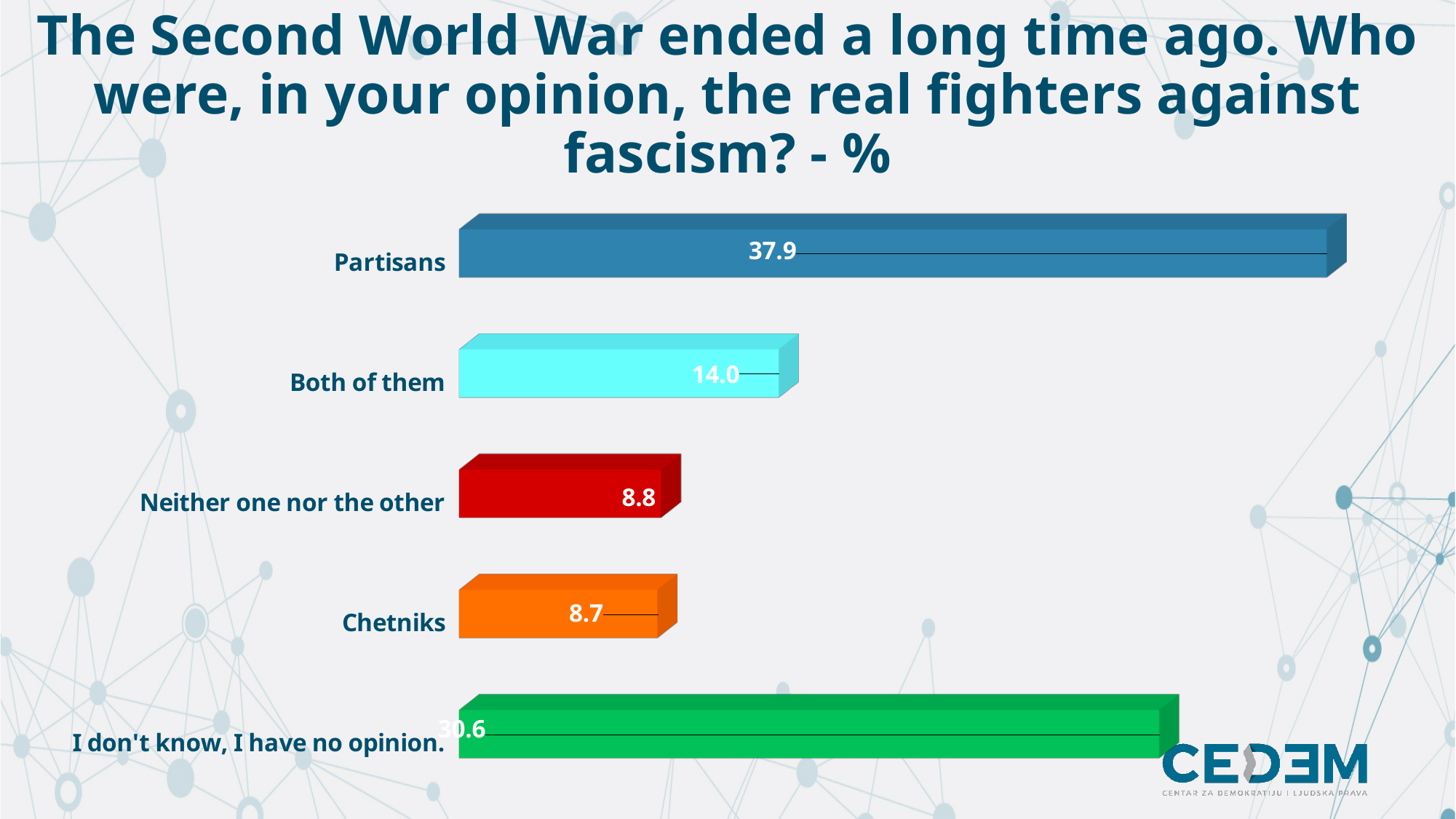
What is the difference between the values for "Both of them" and Chetniks? 5.3 Which category has the highest value? Partisans What is the value for Chetniks? 8.7 What colour is the bar for Chetniks? Orange What percentage of respondents answered Partisans? 37.9 How many categories are shown in the chart? 5 What is the difference between the values for Partisans and "I don't know, I have no opinion."? 7.3 What is the value for "I don't know, I have no opinion."? 30.6 What is the value for "Neither one nor the other"? 8.8 Which is larger, the value for "Both of them" or the value for "I don't know, I have no opinion."? I don't know, I have no opinion. What is the value for "Both of them"? 14.0 What kind of chart is shown on the slide? Bar chart